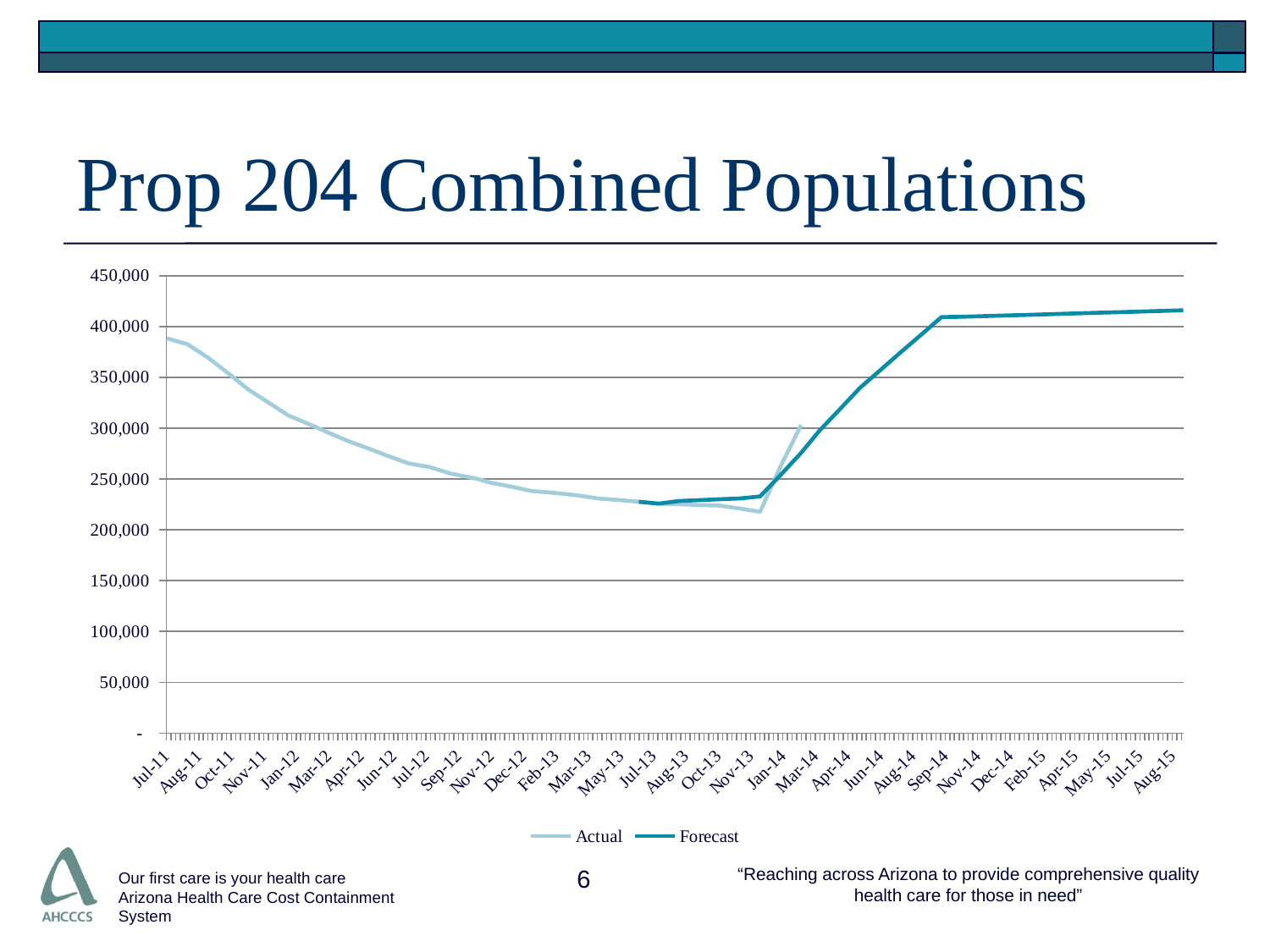
Does the Actual series rise or fall from Jul-11 to Nov-13? fall How many series does the legend list? 2 Is the Actual value at Jul-11 greater or less than 350,000? greater Which is larger: the Forecast value at Aug-15 or the Actual value at Jul-11? Forecast at Aug-15 What are the two series named in the legend? Actual and Forecast Is the Forecast value at Aug-15 greater or less than 400,000? greater What is the title of the chart on the slide? Prop 204 Combined Populations What kind of chart is shown on the slide? line chart What is the highest value shown on the vertical axis? 450,000 Does the Forecast series rise or fall from Jan-14 to Sep-14? rise Is the Actual value at Nov-13 greater or less than 250,000? less